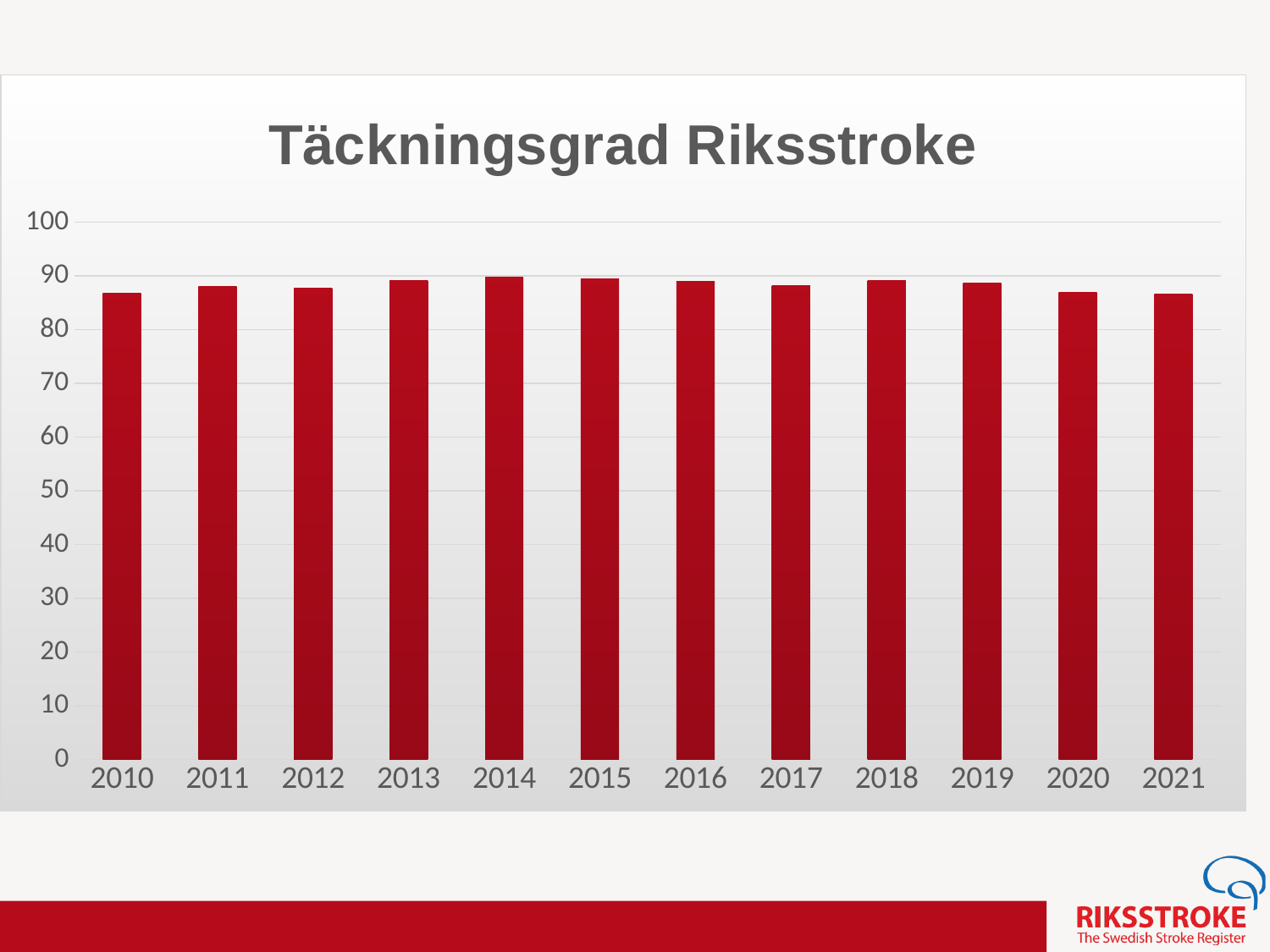
How many years are shown on the x axis of the chart? 12 Which year has the larger value, 2013 or 2020? 2013 Is the value for 2016 greater or less than 80? greater Is the value for 2010 greater or less than 80? greater Is the value for 2021 greater or less than 90? less What kind of chart is shown on the slide? bar chart Which year has the larger value, 2015 or 2010? 2015 Do the values rise or fall from 2018 to 2021? fall What is the title of the chart? Täckningsgrad Riksstroke Which year has the larger value, 2014 or 2021? 2014